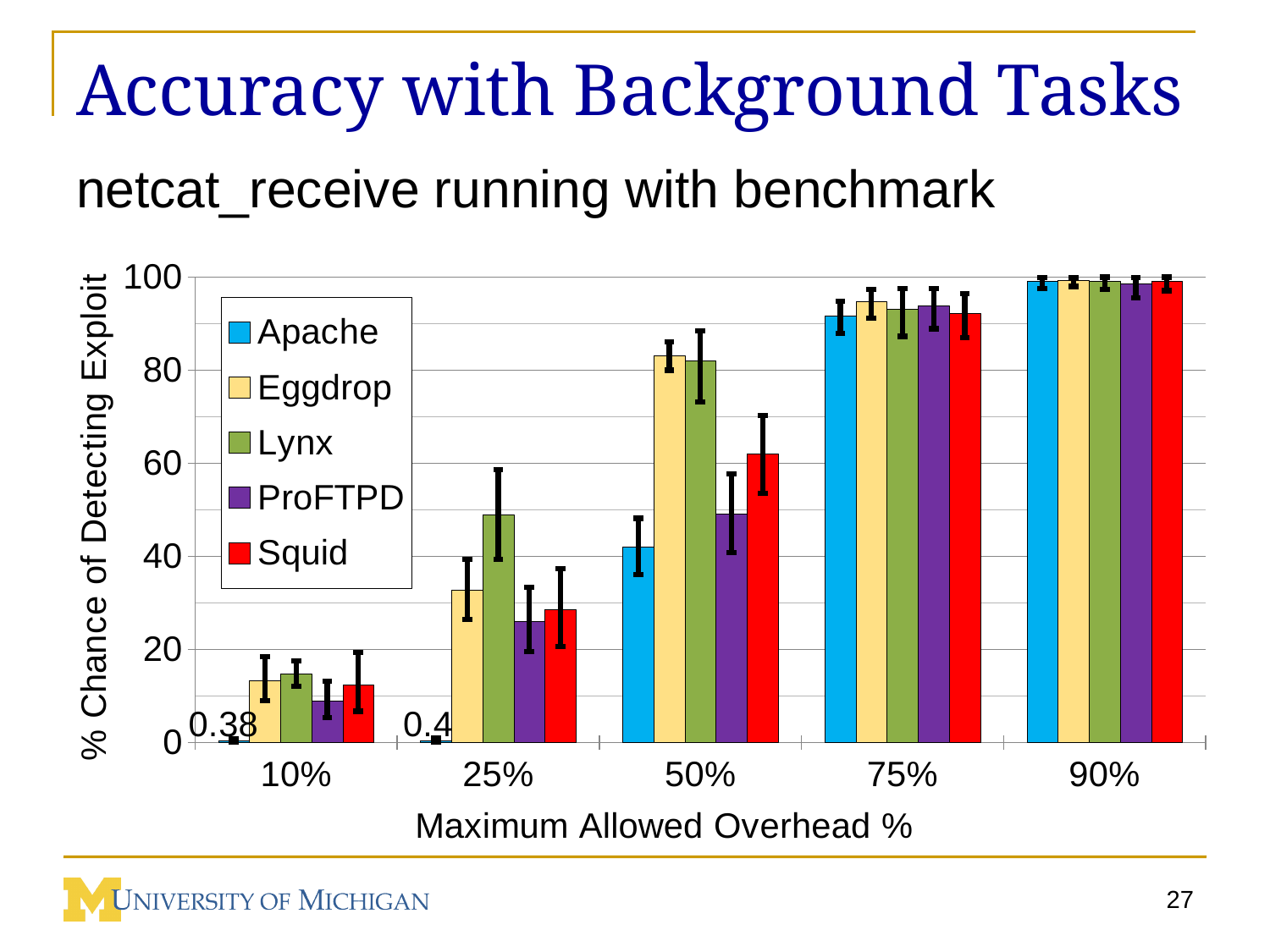
How many Maximum Allowed Overhead categories are shown on the x axis? 5 Do the Apache values rise or fall as the maximum allowed overhead increases along the x axis? rise What is the difference between the Apache values at 25% and 10% maximum allowed overhead? 0.02 Is the value for Lynx at 25% maximum allowed overhead greater or less than 40? greater Is the value for Squid at 50% maximum allowed overhead greater or less than 80? less At 25% maximum allowed overhead, which series has the highest value? Lynx What is the value for Apache at 25% maximum allowed overhead? 0.4 What is the title of the y axis? % Chance of Detecting Exploit At 50% maximum allowed overhead, which is larger, Eggdrop or Squid? Eggdrop How many series does the legend list? 5 What kind of chart is shown on the slide? bar chart What is the value for Apache at 10% maximum allowed overhead? 0.38